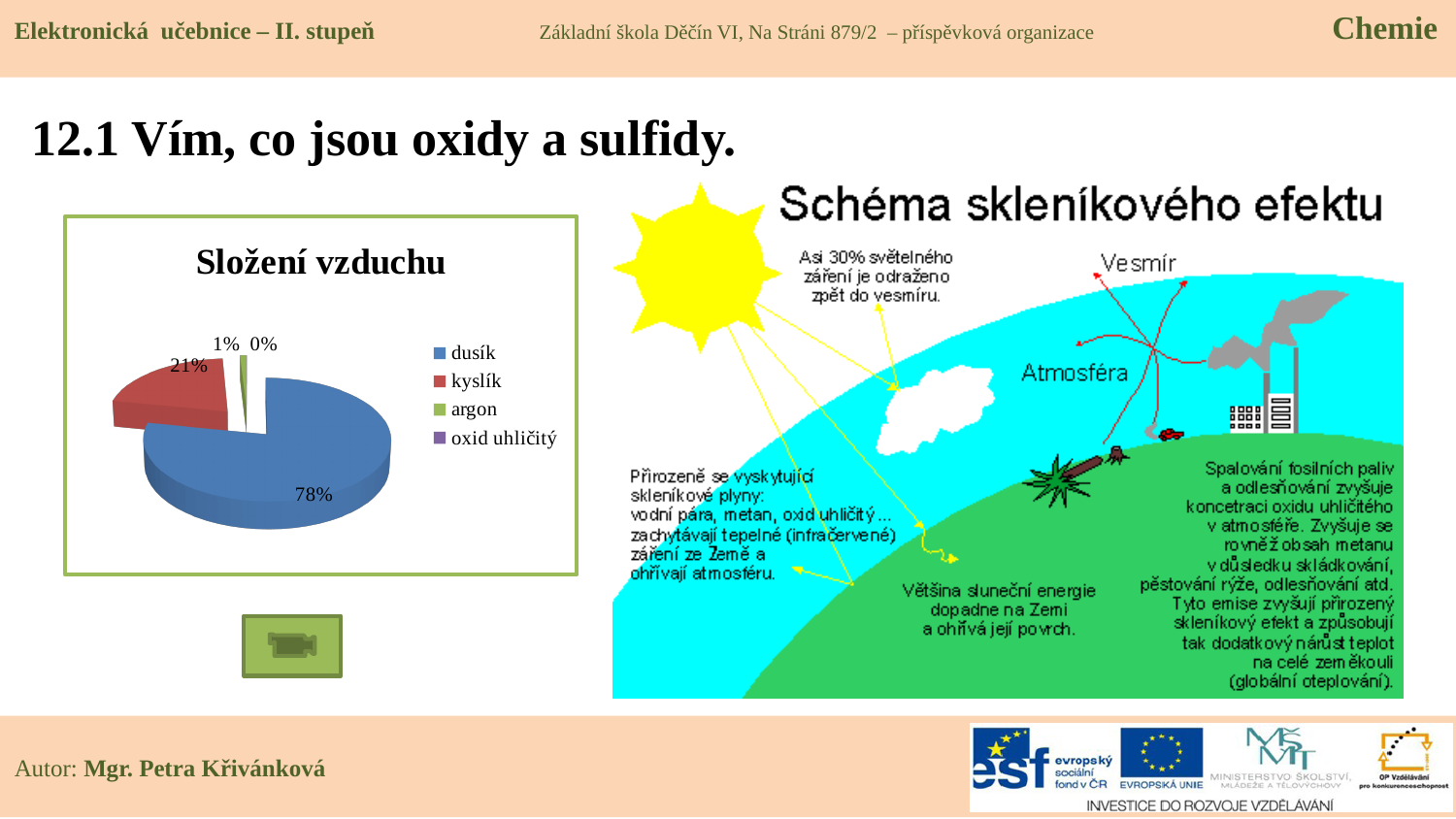
In the 'Složení vzduchu' chart, what percentage is shown for argon? 1% How many components are listed in the legend of the 'Složení vzduchu' chart? 4 Which component has the largest slice in the 'Složení vzduchu' chart? dusík What kind of chart is the 'Složení vzduchu' chart? pie chart In the 'Složení vzduchu' chart, which is larger: kyslík or argon? kyslík In the 'Složení vzduchu' chart, by how many percentage points does dusík exceed kyslík? 57 In the 'Složení vzduchu' chart, what percentage is shown for dusík? 78% Which component has the smallest slice in the 'Složení vzduchu' chart? oxid uhličitý What share of the pie in the 'Složení vzduchu' chart does kyslík take? 21% What is the title of the pie chart on the left of the slide? Složení vzduchu In the 'Složení vzduchu' chart, what percentage is shown for kyslík? 21% In the 'Složení vzduchu' chart, what percentage is shown for oxid uhličitý? 0%